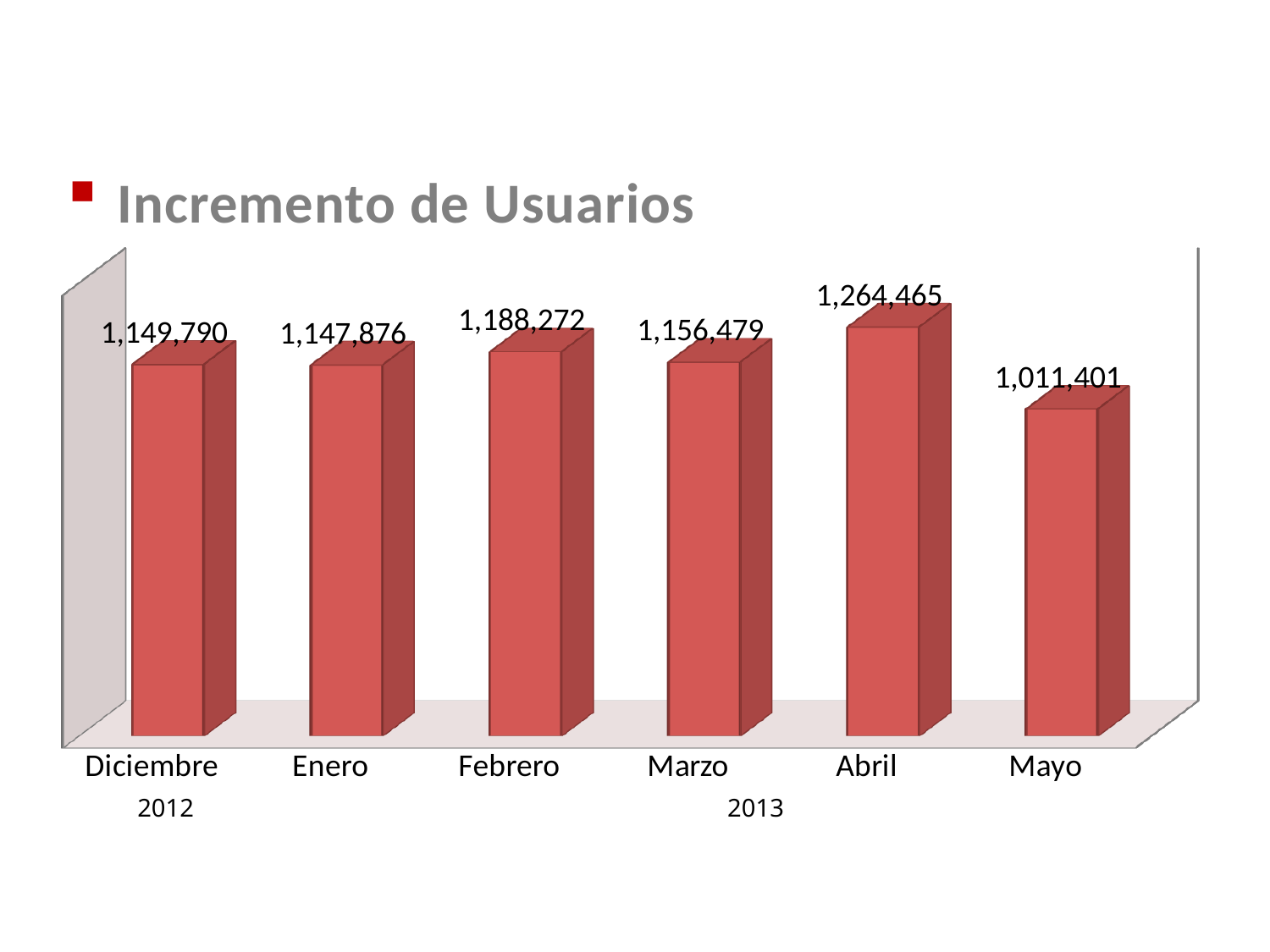
What kind of chart is shown on the slide? Bar chart What is the value for Mayo? 1,011,401 Which month has the highest value? Abril What is the difference between the values for Febrero and Enero? 40,396 What is the value for Diciembre? 1,149,790 What is the difference between the values for Abril and Mayo? 253,064 What is the value for Abril? 1,264,465 Which month has the lowest value? Mayo What is the value for Febrero? 1,188,272 Which is larger, the value for Febrero or the value for Marzo? Febrero What is the title of the chart? Incremento de Usuarios How many months are shown in the chart? 6